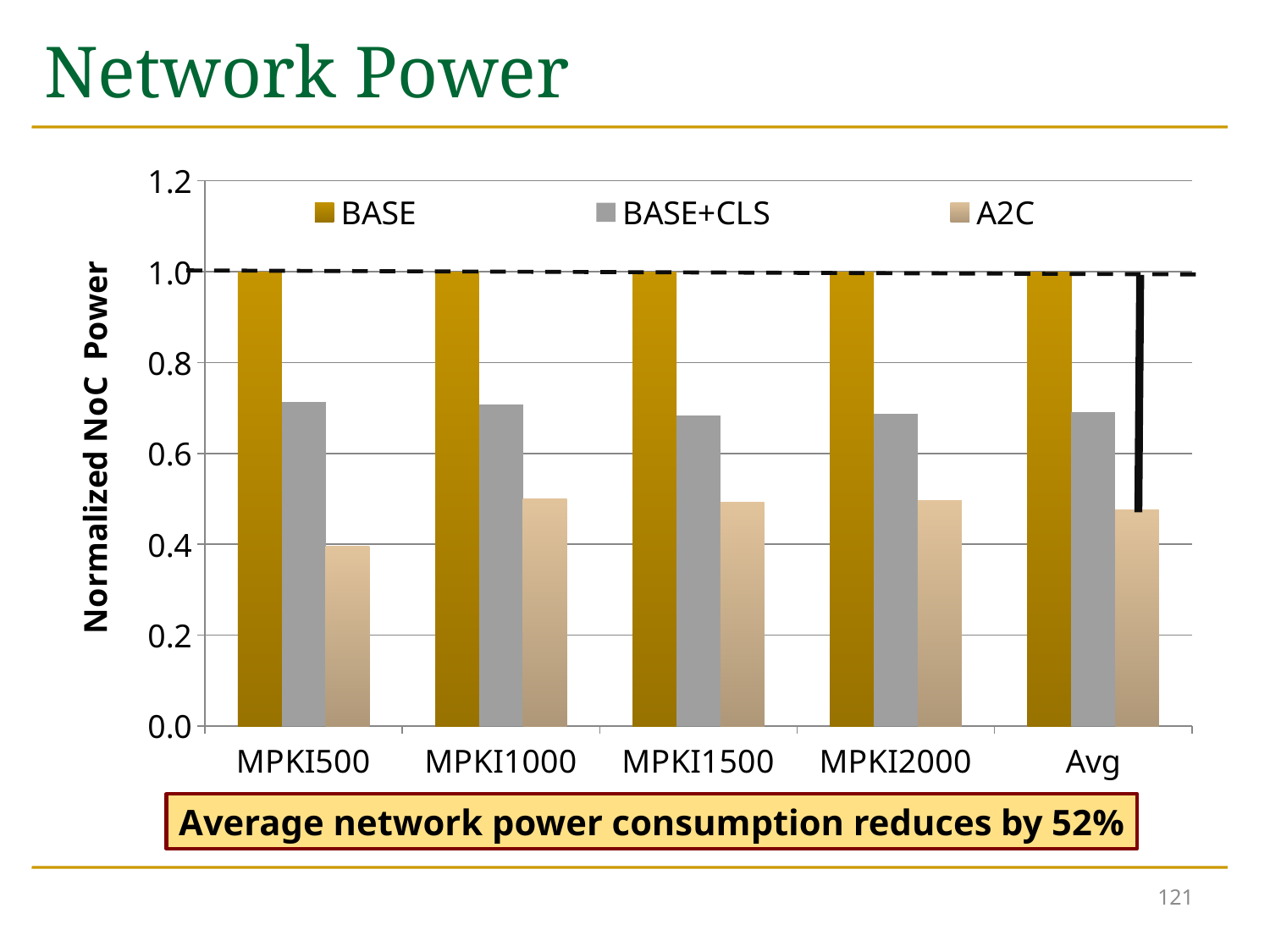
Is the value for BASE+CLS at MPKI1000 greater or less than 0.6? greater What kind of chart is shown on the slide? bar chart How many series does the legend list? 3 Which series has the highest value at MPKI2000? BASE What is the normalized NoC power for BASE at MPKI500? 1.0 What is the normalized NoC power for BASE at Avg? 1.0 How many categories are shown on the x axis? 5 Is the value for A2C at Avg greater or less than 0.6? less For the A2C series, which category has the lowest value? MPKI500 Which series has the lowest value at MPKI1500? A2C What is the label of the y axis? Normalized NoC Power Which is larger at MPKI2000, BASE+CLS or A2C? BASE+CLS